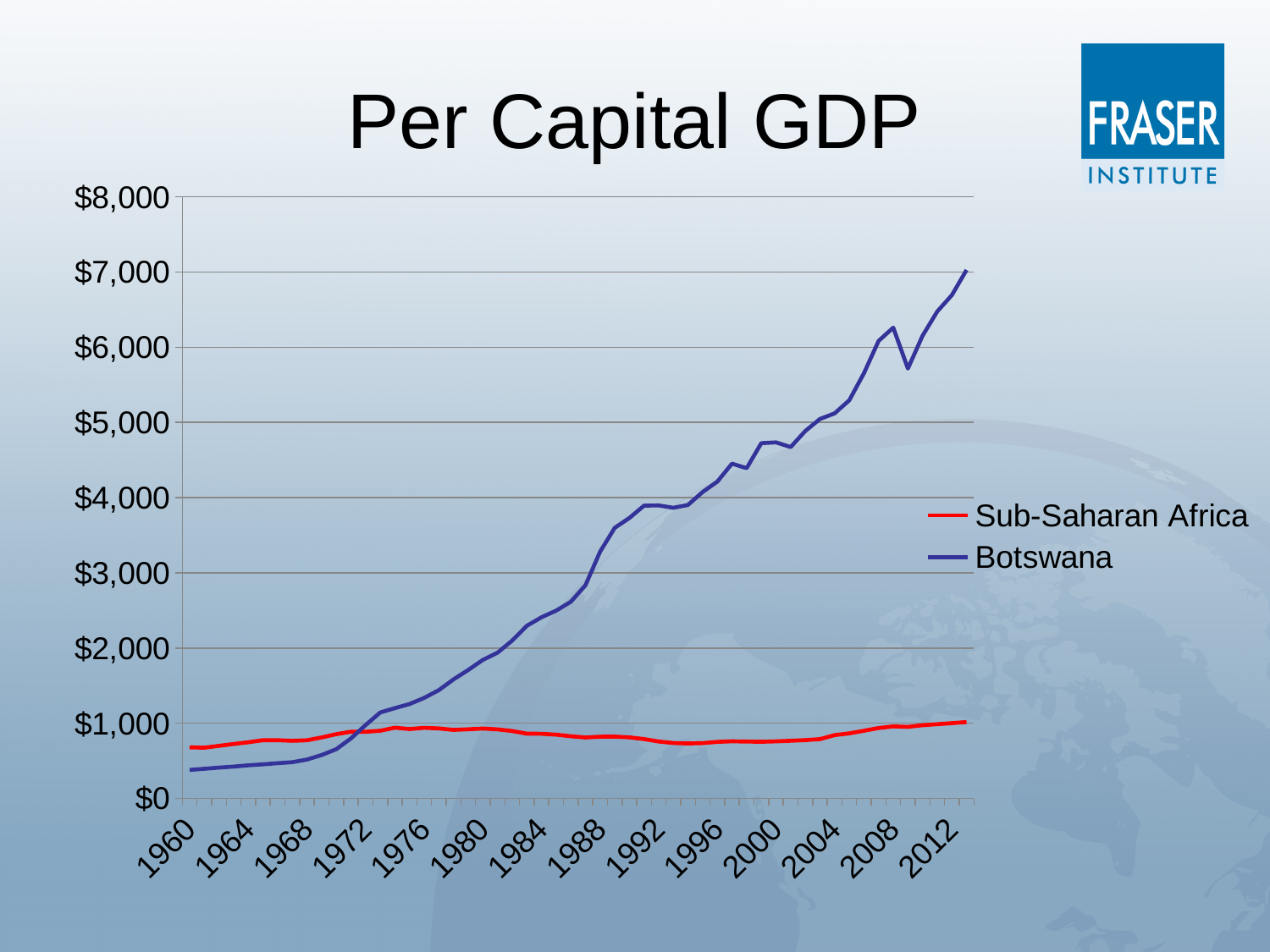
How many year labels are shown on the x axis? 14 Is the value for Botswana in 2000 greater or less than $4,000? greater Is the value for Sub-Saharan Africa in 2012 greater or less than $2,000? less How many series does the legend list? 2 Which series is drawn in red? Sub-Saharan Africa Which series has the larger value in 2012, Botswana or Sub-Saharan Africa? Botswana Is the value for Botswana in 2012 greater or less than $6,000? greater What kind of chart is shown on the slide? line chart Does the Botswana line generally rise or fall from 1960 to 2012? rise Which series has the larger value in 1960, Botswana or Sub-Saharan Africa? Sub-Saharan Africa What is the title of the chart? Per Capital GDP